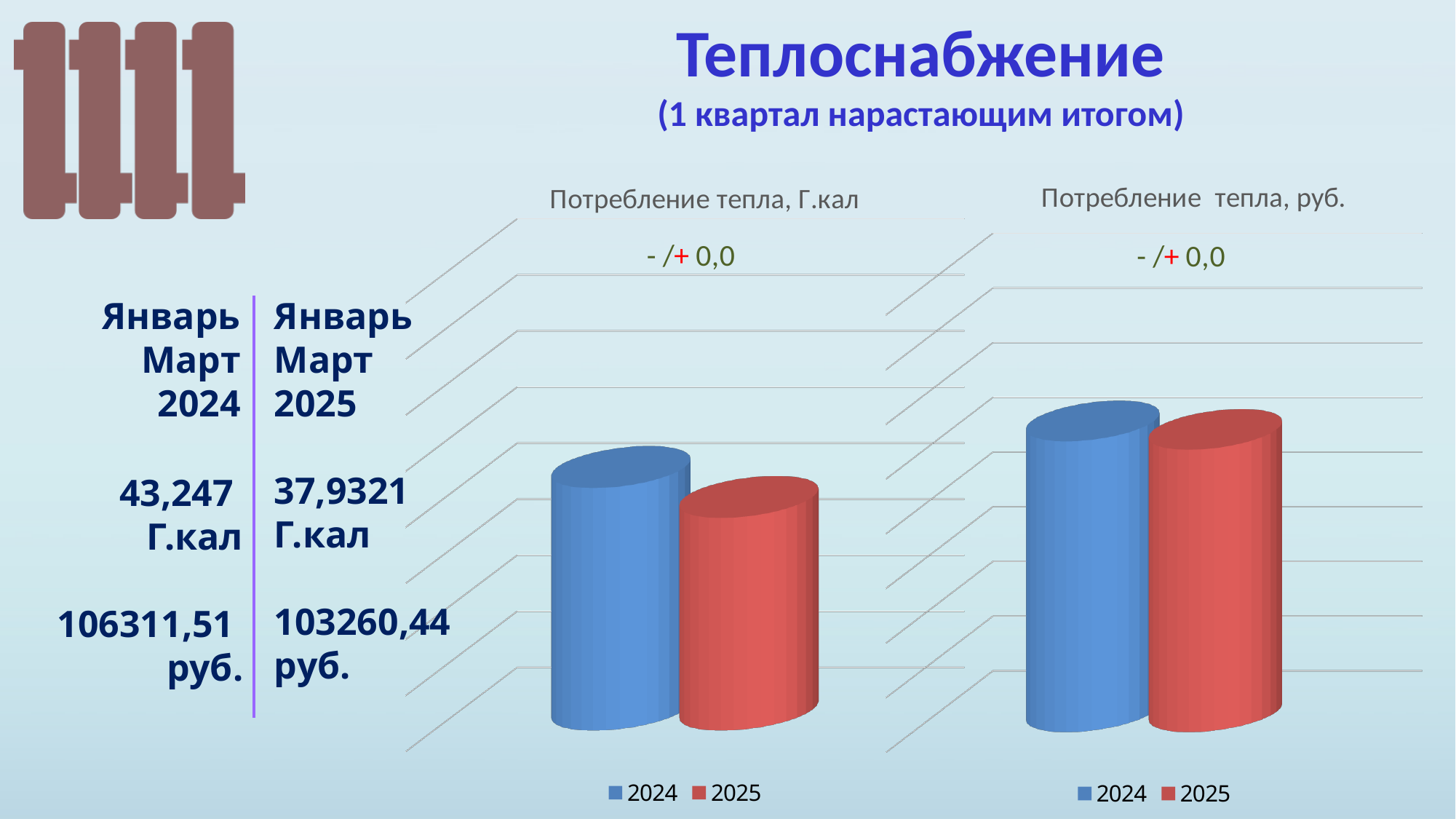
What kind of chart is the "Потребление тепла, Г.кал" chart? bar chart According to the slide, what is the heat consumption in Г.кал for January–March 2024? 43,247 Г.кал How many series does the legend of the "Потребление тепла, руб." chart list? 2 In the "Потребление тепла, руб." chart, which series has the highest bar? 2024 How many bars are plotted in the "Потребление тепла, Г.кал" chart? 2 According to the slide, what is the heat consumption in rubles for January–March 2025? 103260,44 руб. In the "Потребление тепла, Г.кал" chart, which series has the taller bar, 2024 or 2025? 2024 Do the values in the "Потребление тепла, руб." chart rise or fall from 2024 to 2025? fall In the "Потребление тепла, руб." chart, which series has the lower bar? 2025 Which colour represents the 2025 series in the legends of the charts? red According to the slide, what is the heat consumption in Г.кал for January–March 2025? 37,9321 Г.кал According to the slide, what is the heat consumption in rubles for January–March 2024? 106311,51 руб.